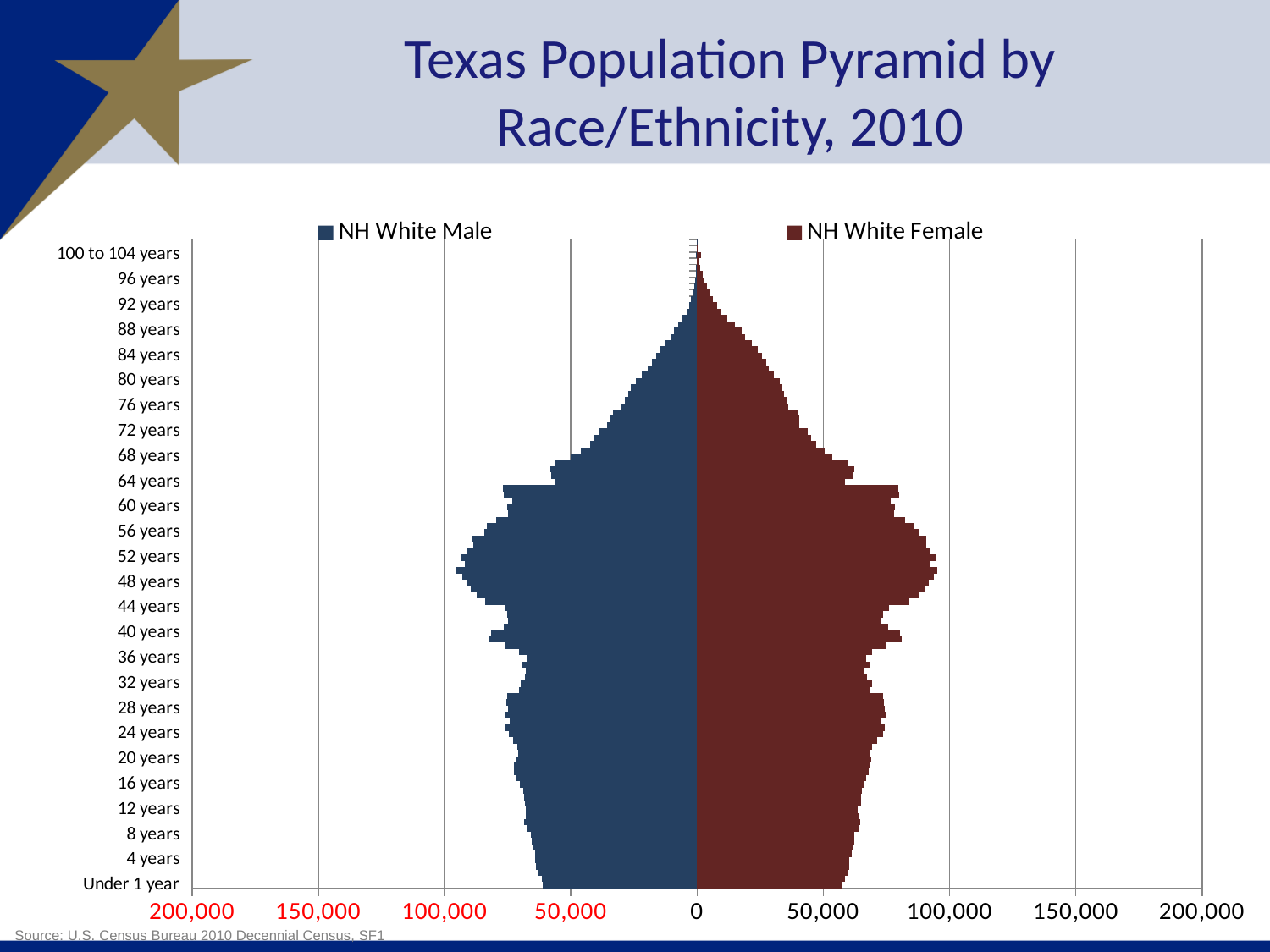
Is the NH White Female value for 48 years greater or less than 50,000? greater How many series does the legend list? 2 Is the NH White Male value for 76 years greater or less than 50,000? less Do the NH White Male values rise or fall as age increases from 48 years to 100 to 104 years? fall What is the title of the chart? Texas Population Pyramid by Race/Ethnicity, 2010 Is the NH White Female value for 100 to 104 years greater or less than 50,000? less What kind of chart is shown on the slide? bar chart What are the two series named in the legend? NH White Male and NH White Female At 88 years, which series has the larger value, NH White Male or NH White Female? NH White Female Which is larger, the NH White Female value for 48 years or for 92 years? 48 years